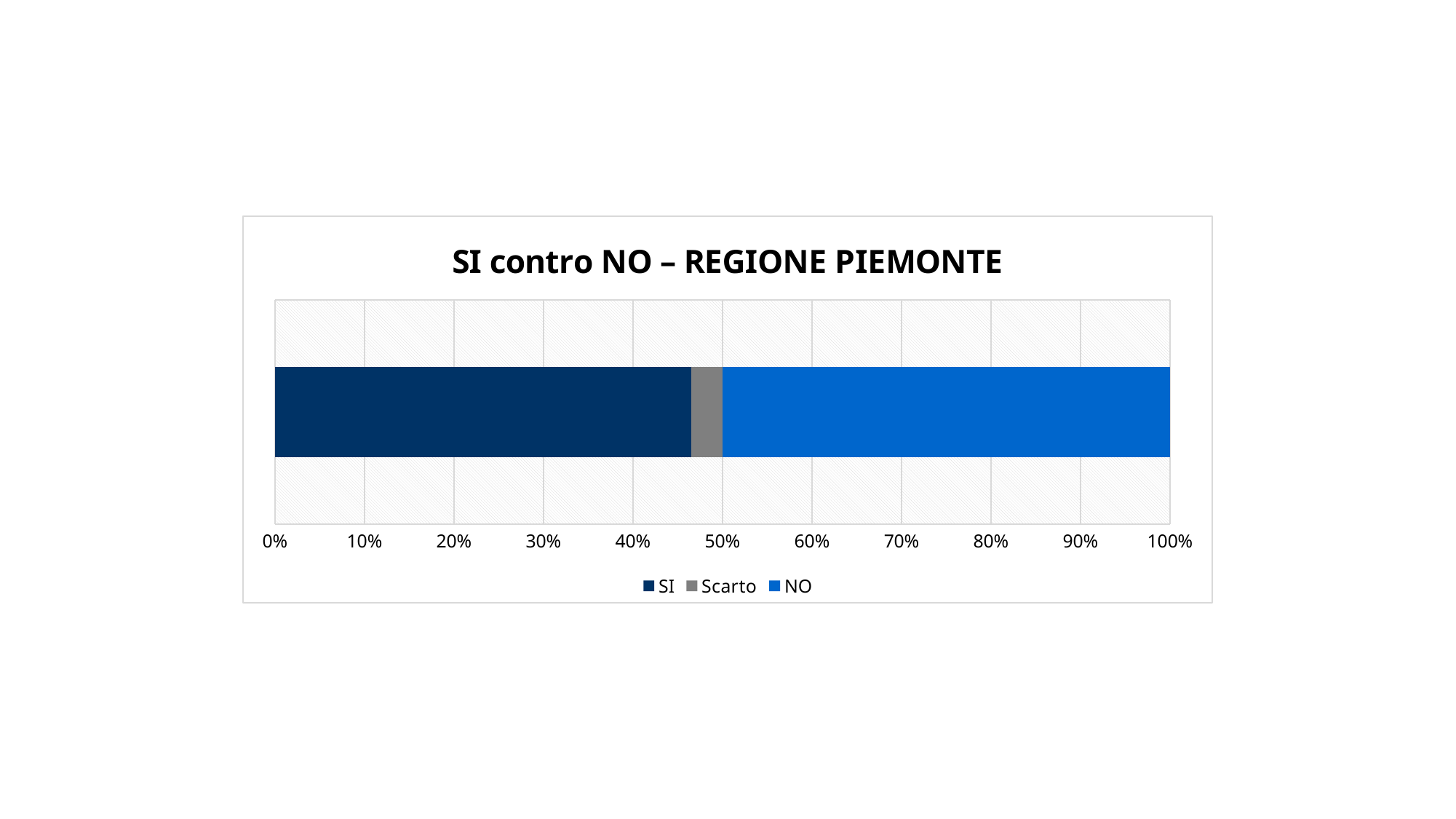
What is the title of the chart? SI contro NO – REGIONE PIEMONTE Which series has the smallest share of the bar? Scarto How many series does the legend list? 3 What kind of chart is shown on the slide? Stacked bar chart Is the value for SI greater or less than 50%? less How many bars are plotted in the chart? 1 Is the value for SI greater or less than 40%? greater Which is larger, the NO segment or the Scarto segment? NO Which is larger, the SI segment or the Scarto segment? SI Which series are listed in the legend, in order? SI, Scarto, NO Is the value for NO greater or less than 40%? greater